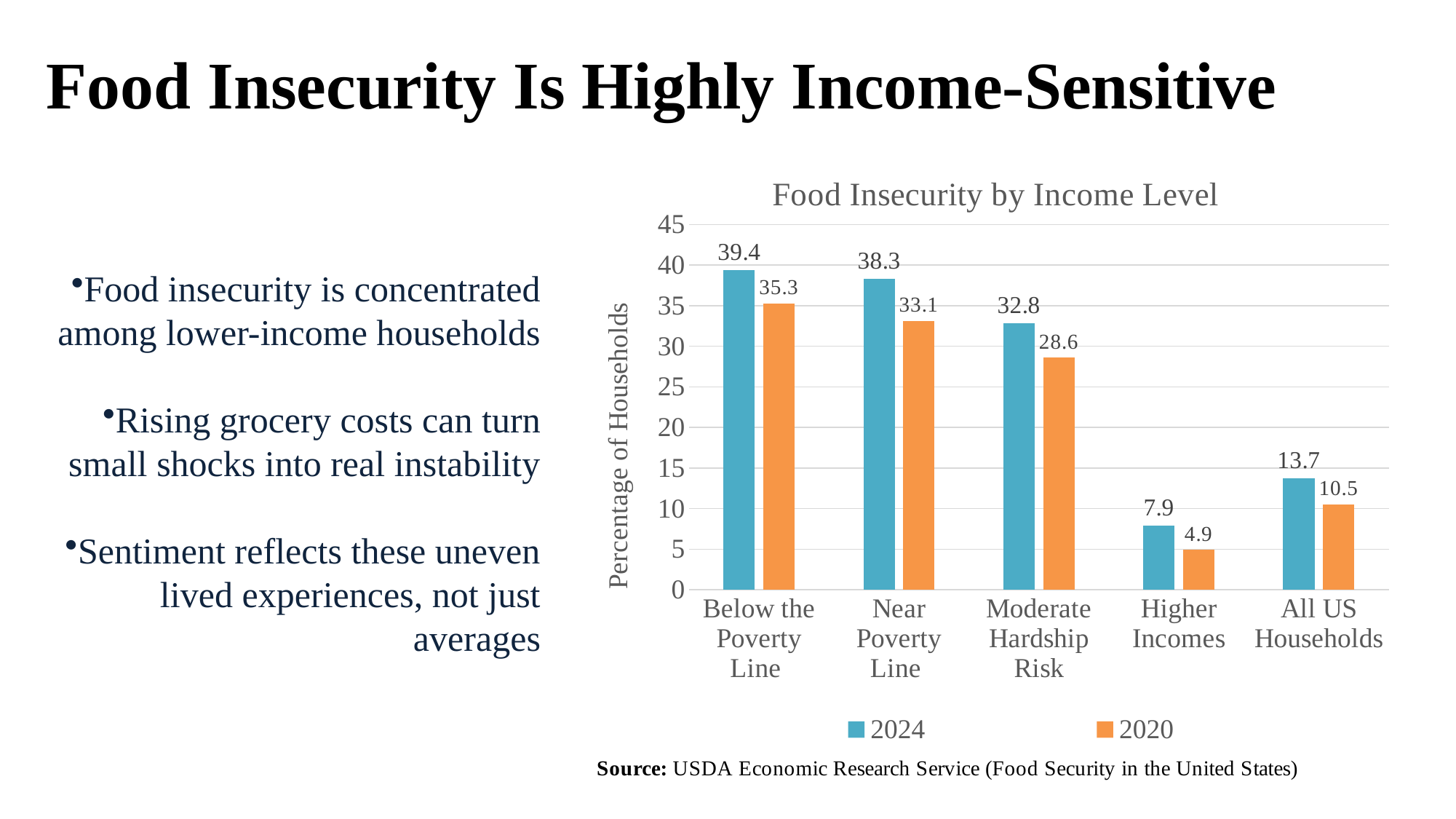
Which category has the lowest 2020 value? Higher Incomes What is the 2024 value for Below the Poverty Line? 39.4 What is the difference between the 2024 and 2020 values for Near Poverty Line? 5.2 What is the 2020 value for Moderate Hardship Risk? 28.6 What is the 2024 value for All US Households? 13.7 What is the title of the chart? Food Insecurity by Income Level Which is larger: the 2024 value for Higher Incomes or the 2020 value for All US Households? 2020 value for All US Households What kind of chart is shown? Bar chart How many series does the legend list? 2 Which category has the highest 2024 value? Below the Poverty Line How many income categories are shown on the x axis? 5 What is the label of the vertical axis? Percentage of Households